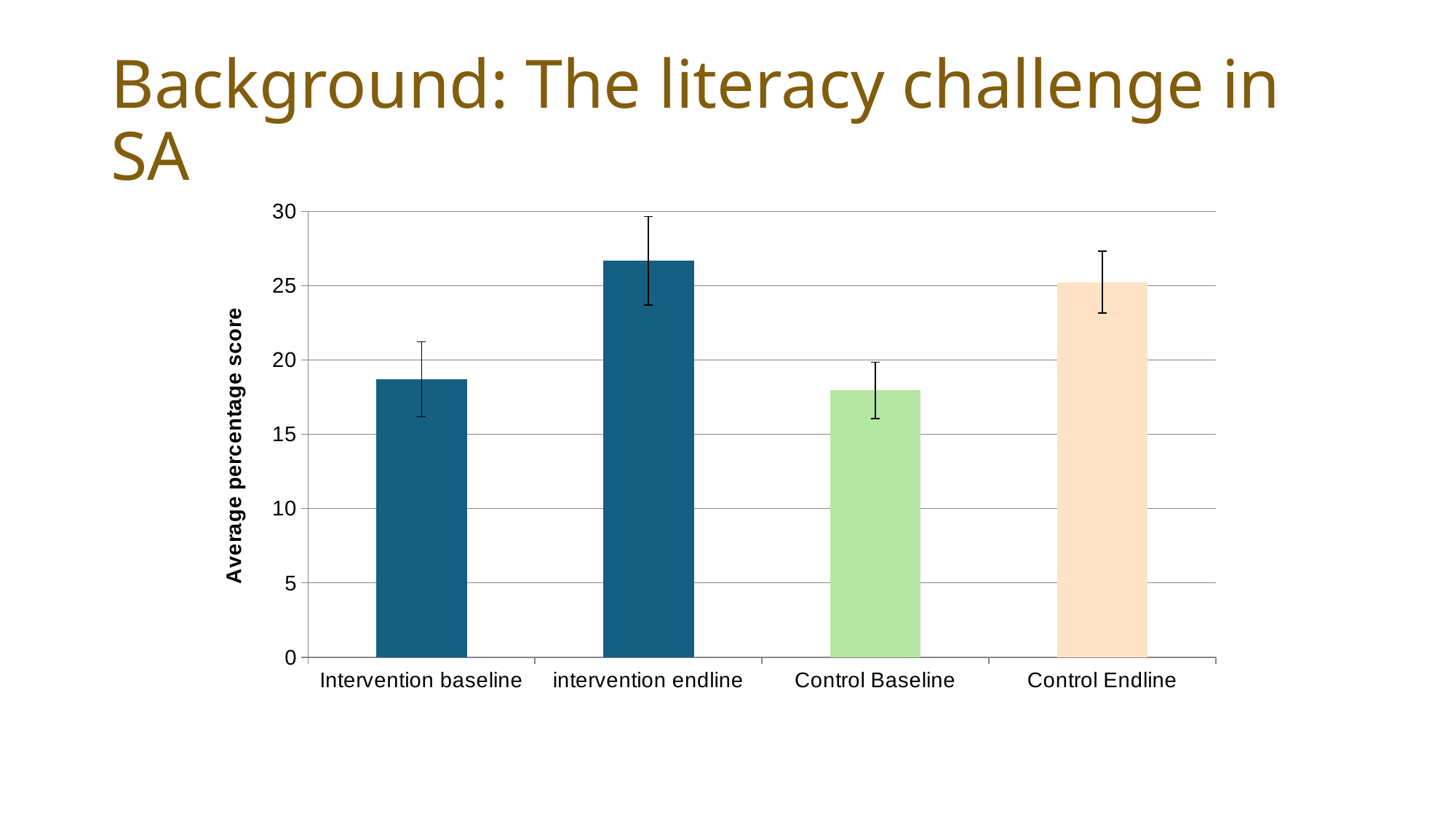
What is the title of the vertical axis? Average percentage score Is the value for Control Endline greater or less than 20? greater Is the value for Control Baseline greater or less than 20? less How many categories are plotted on the chart? 4 Is the value for intervention endline greater or less than 25? greater What kind of chart is shown on the slide? bar chart Which is larger, the value for Intervention baseline or the value for intervention endline? intervention endline What colour is the Control Baseline bar? light green Which category has the highest average percentage score? intervention endline Which is larger, the value for Control Baseline or the value for Control Endline? Control Endline